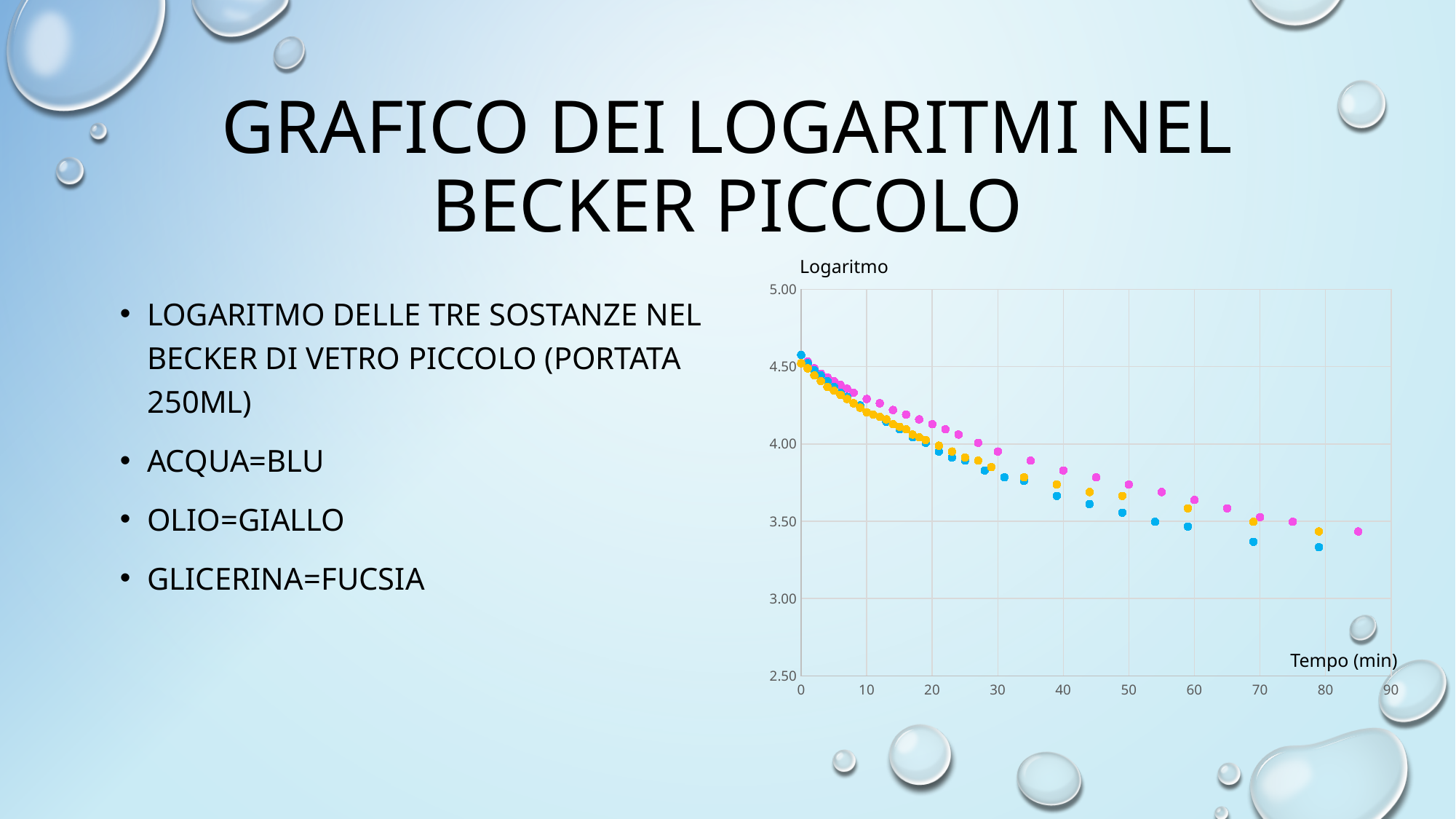
How many series (substances) are plotted on the chart? 3 Which series has the lowest values at the right end of the chart (around 80 minutes)? blue (acqua) What is the highest value shown on the vertical axis of the chart? 5.00 Is the value of the yellow (olio) series at 30 minutes greater or less than 4.00? less Which colour represents glicerina on the chart? fucsia Do the plotted values rise or fall as time (Tempo) increases? fall At 60 minutes, which series has the higher value: the fuchsia (glicerina) series or the blue (acqua) series? fuchsia (glicerina) Is the value of the fuchsia (glicerina) series at 60 minutes greater or less than 3.50? greater What kind of chart is shown on the slide? scatter chart Which substance is plotted in blue? Acqua Is the value of the blue (acqua) series at 80 minutes greater or less than 3.50? less At 80 minutes, which series has the higher value: the yellow (olio) series or the blue (acqua) series? yellow (olio)